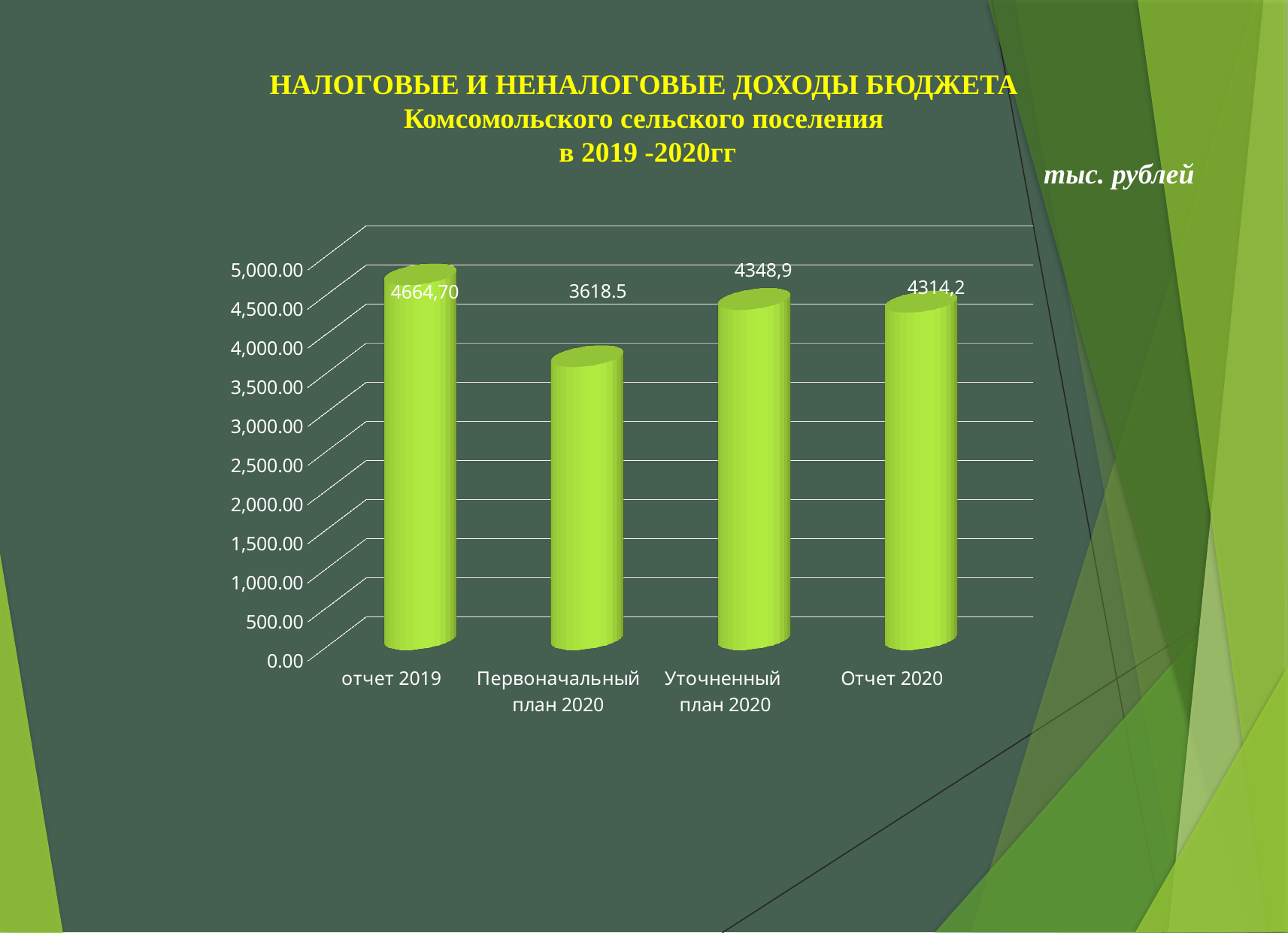
Is the value for Первоначальный план 2020 greater or less than 4,000.00? less Which category has the highest value? отчет 2019 How many categories are shown on the x axis? 4 Which category has the lowest value? Первоначальный план 2020 What is the value for Уточненный план 2020? 4348,9 In what units are the values on the chart expressed, according to the slide? тыс. рублей What is the difference between the values for отчет 2019 and Первоначальный план 2020? 1046.2 Which is larger, the value for Уточненный план 2020 or the value for Отчет 2020? Уточненный план 2020 What is the value for Первоначальный план 2020? 3618.5 What kind of chart is shown on the slide? bar chart What is the value for Отчет 2020? 4314,2 What is the value for отчет 2019? 4664,70